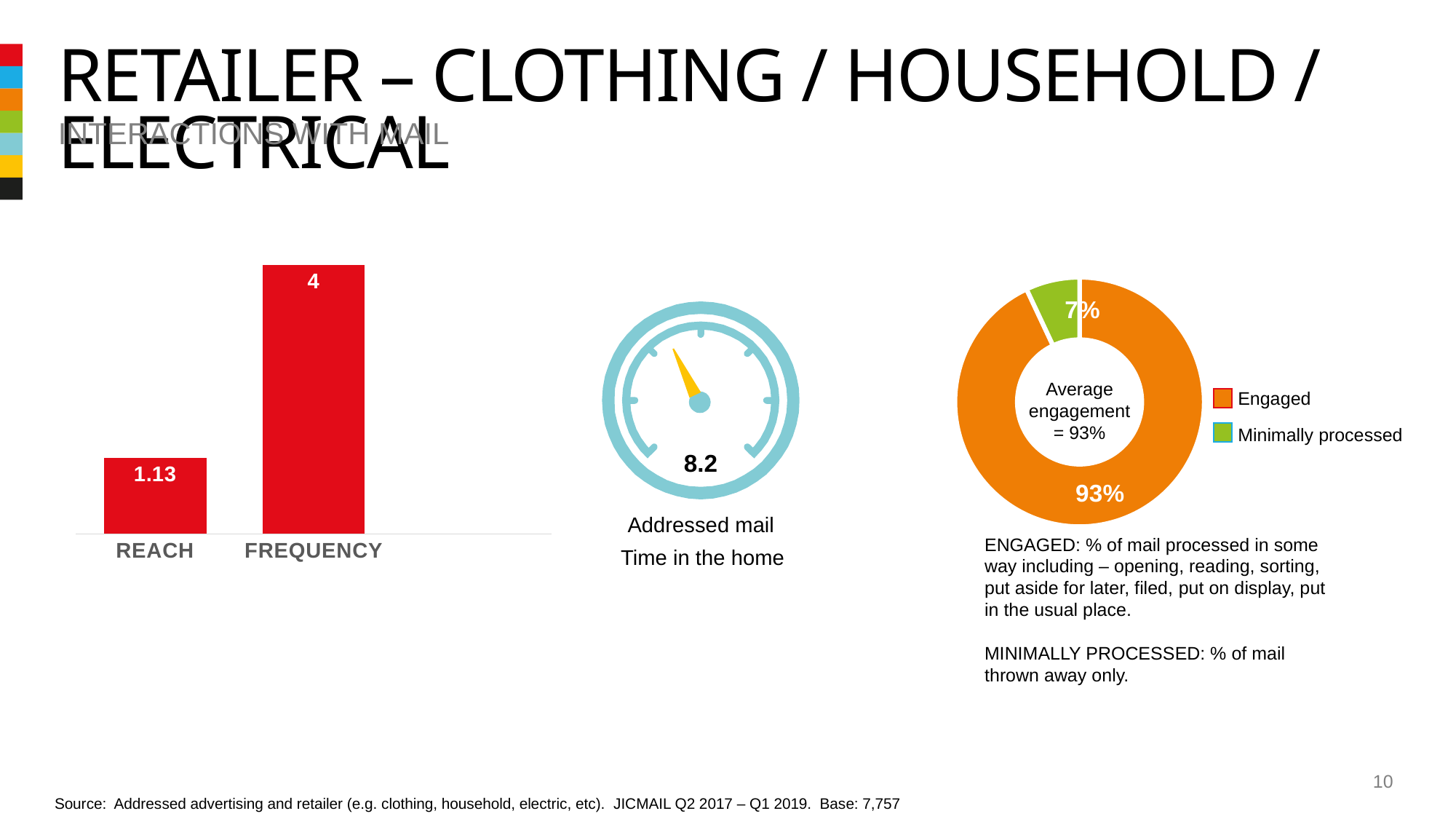
How many entries does the legend of the donut chart on the right list? 2 In the bar chart on the left, how many categories are shown? 2 In the donut chart on the right, what share is labelled Engaged? 93% In the bar chart on the left, what is the value for FREQUENCY? 4 In the donut chart on the right, what colour is the Minimally processed segment? Green In the donut chart on the right, which segment is larger, Engaged or Minimally processed? Engaged What kind of chart is shown on the left of the slide? Bar chart In the bar chart on the left, what is the value for REACH? 1.13 In the bar chart on the left, which category has the higher value? FREQUENCY In the bar chart on the left, which category has the lower value? REACH In the bar chart on the left, what is the difference between the FREQUENCY and REACH values? 2.87 In the donut chart on the right, what share is labelled Minimally processed? 7%